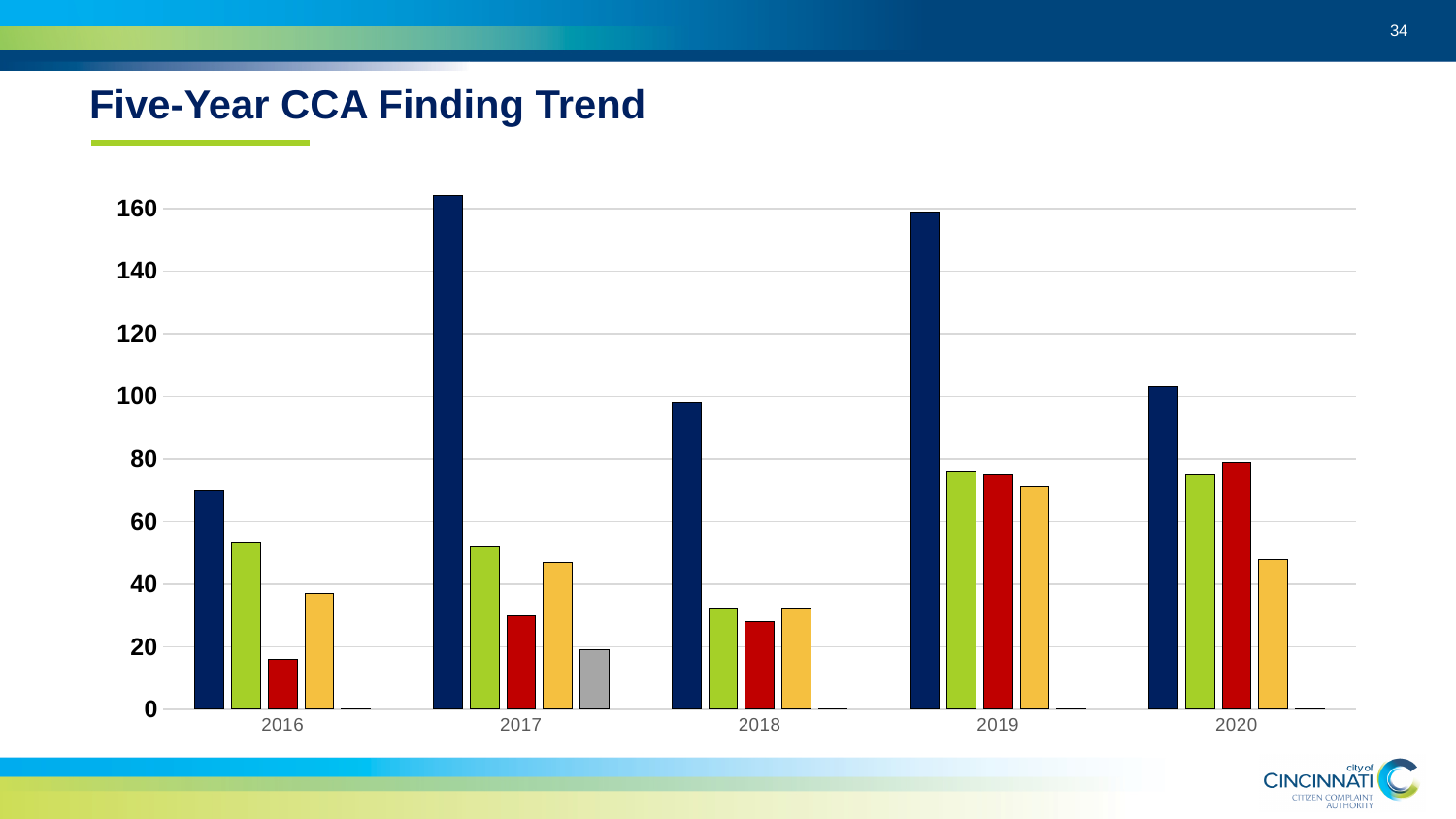
How many years are shown on the x axis of the chart? 5 Is the red bar for 2016 greater or less than 20? less Which year is the only one with a gray bar? 2017 What is the title of the chart on the slide? Five-Year CCA Finding Trend What kind of chart is shown on the slide? bar chart Is the yellow bar for 2020 greater or less than 60? less Is the dark blue bar for 2019 greater or less than 140? greater Which is larger, the red bar for 2020 or the red bar for 2016? 2020 In which year is the yellow bar the tallest? 2019 In which year is the dark blue bar the shortest? 2016 In which year is the dark blue bar the tallest? 2017